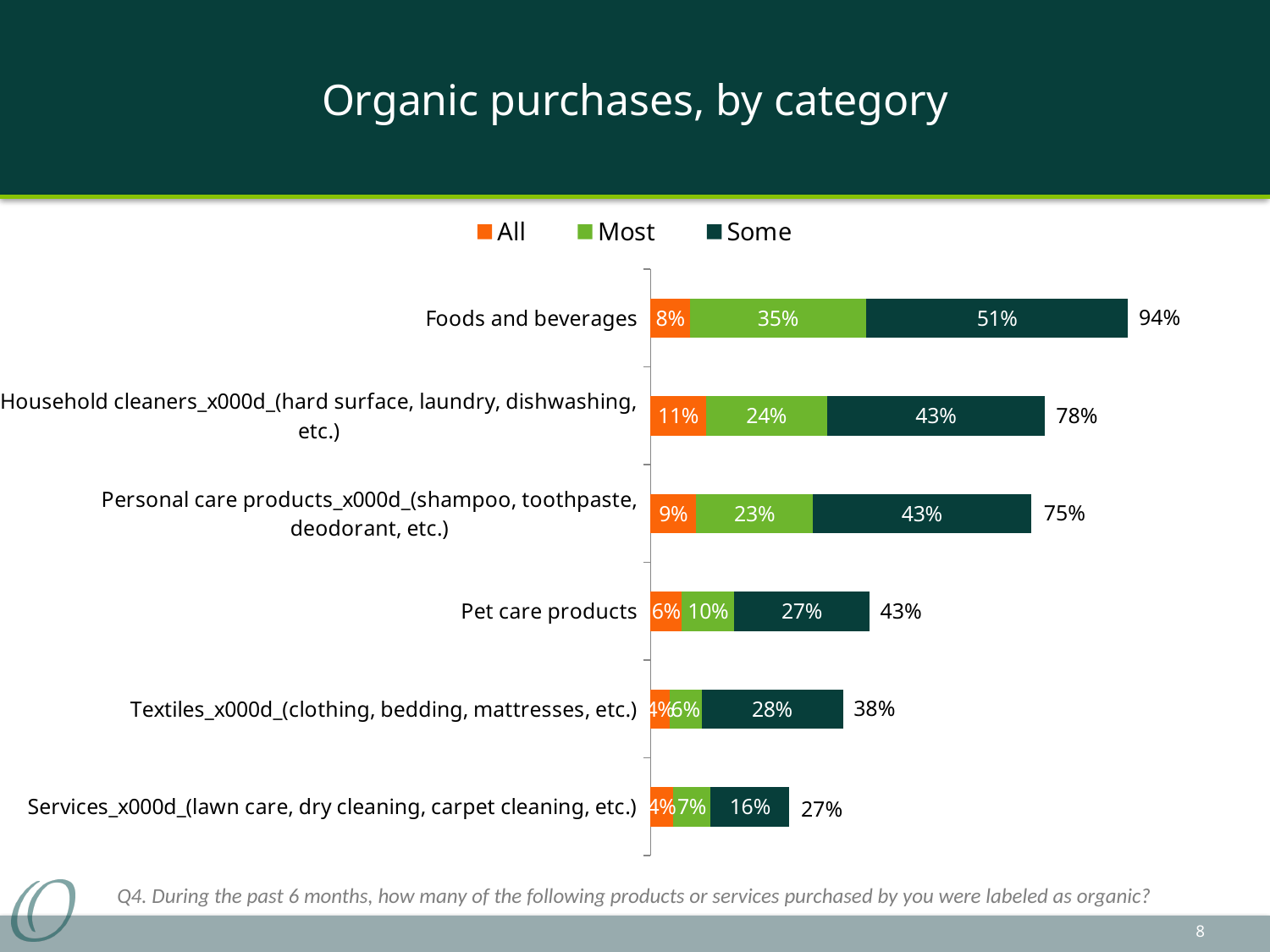
What is the difference between the totals for Foods and beverages and Household cleaners? 16% What is the title of the chart? Organic purchases, by category What is the total shown for the Pet care products bar? 43% What is the 'Most' value for Personal care products? 23% What kind of chart is shown on the slide? Stacked bar chart How many series does the legend list? 3 Which is larger, the 'Some' value for Textiles or the 'Some' value for Services? Textiles What is the 'Some' value for Foods and beverages? 51% Which category has the lowest total? Services Which category has the highest total? Foods and beverages What is the 'All' value for Household cleaners? 11% How many categories are plotted in the chart? 6